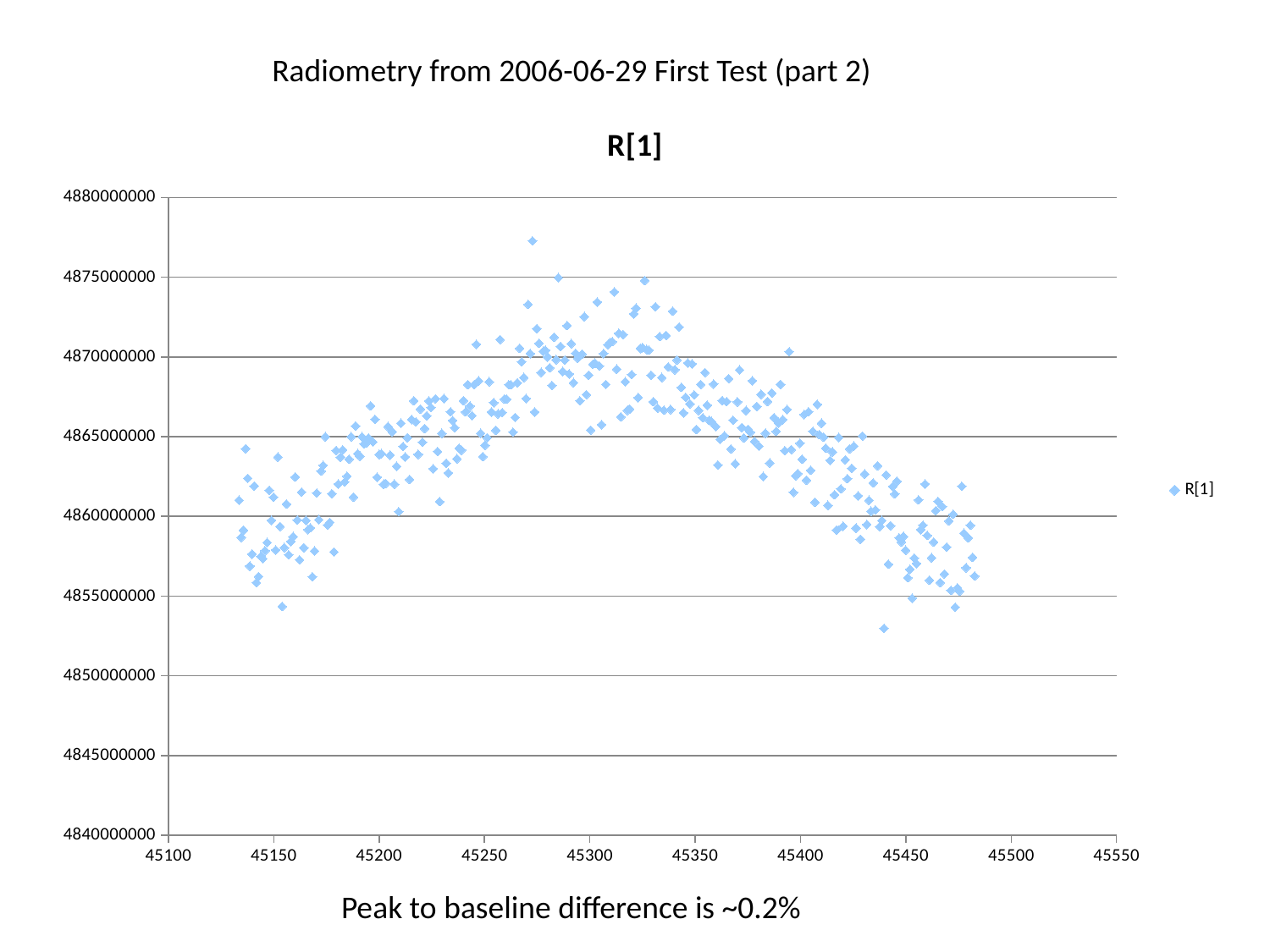
Are the values plotted near x = 45300 greater or less than 4865000000? greater Is the lowest plotted value greater or less than 4850000000? greater What is the title of the chart? R[1] Is the highest plotted value greater or less than 4875000000? greater How many series does the legend list? 1 Do the plotted values generally rise or fall as x increases from 45350 to 45480? fall What is the name of the series shown in the legend? R[1] Do the plotted values generally rise or fall as x increases from 45150 to 45300? rise What kind of chart is shown on the slide? scatter chart